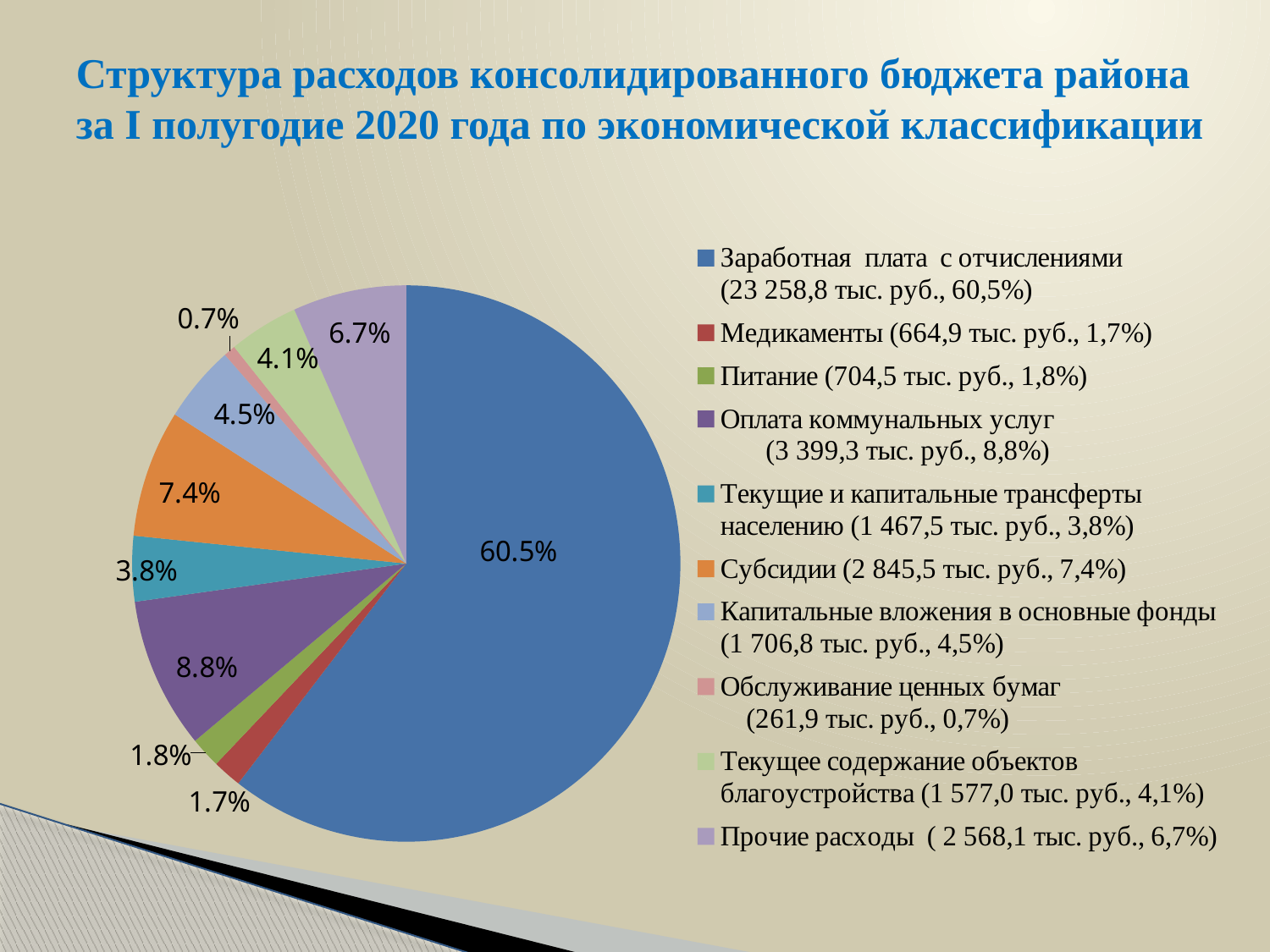
What kind of chart is shown on the slide? pie chart Which category has the largest slice of the pie? Заработная плата с отчислениями What colour is the slice for "Субсидии"? orange What share of the pie does "Субсидии" take? 7.4% What share of the pie does "Заработная плата с отчислениями" take? 60.5% Which category has the smallest slice of the pie? Обслуживание ценных бумаг What share of the pie does "Обслуживание ценных бумаг" take? 0.7% Which is larger: the share for "Прочие расходы" or the share for "Капитальные вложения в основные фонды"? Прочие расходы According to the legend, what amount in thousand rubles corresponds to "Медикаменты"? 664,9 тыс. руб. How many slices does the pie chart have? 10 What is the difference in percentage points between the share for "Субсидии" and the share for "Текущие и капитальные трансферты населению"? 3.6